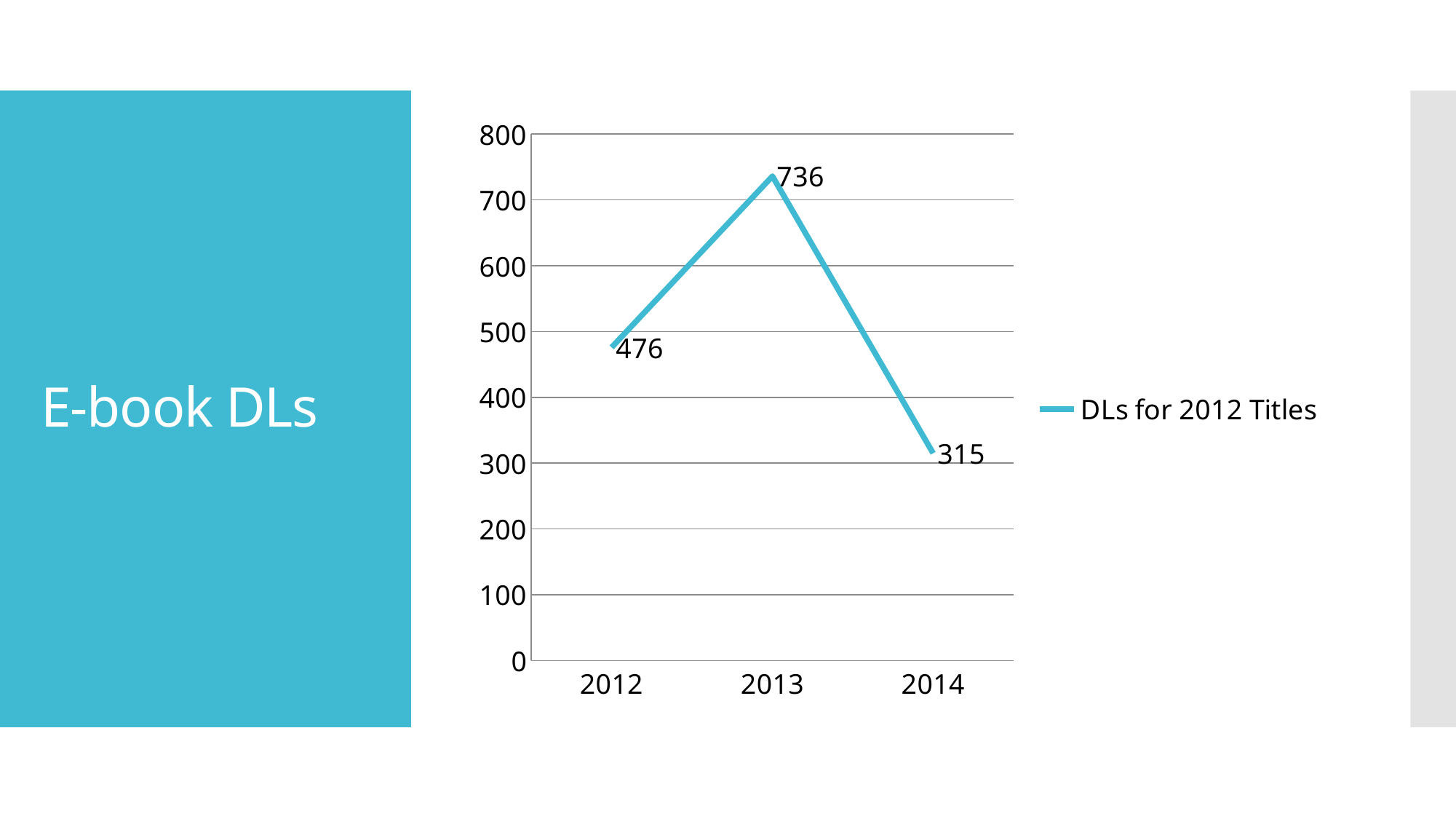
What series name does the legend show? DLs for 2012 Titles What is the value for 2013? 736 Is the value for 2013 greater or less than 700? greater What kind of chart is shown? line chart What is the difference between the values for 2013 and 2012? 260 What is the difference between the values for 2012 and 2014? 161 Which year has the lowest value? 2014 Which is larger, the value for 2012 or the value for 2014? 2012 How many years are plotted on the x axis? 3 What is the value for 2014? 315 Which year has the highest value? 2013 What is the value for 2012? 476